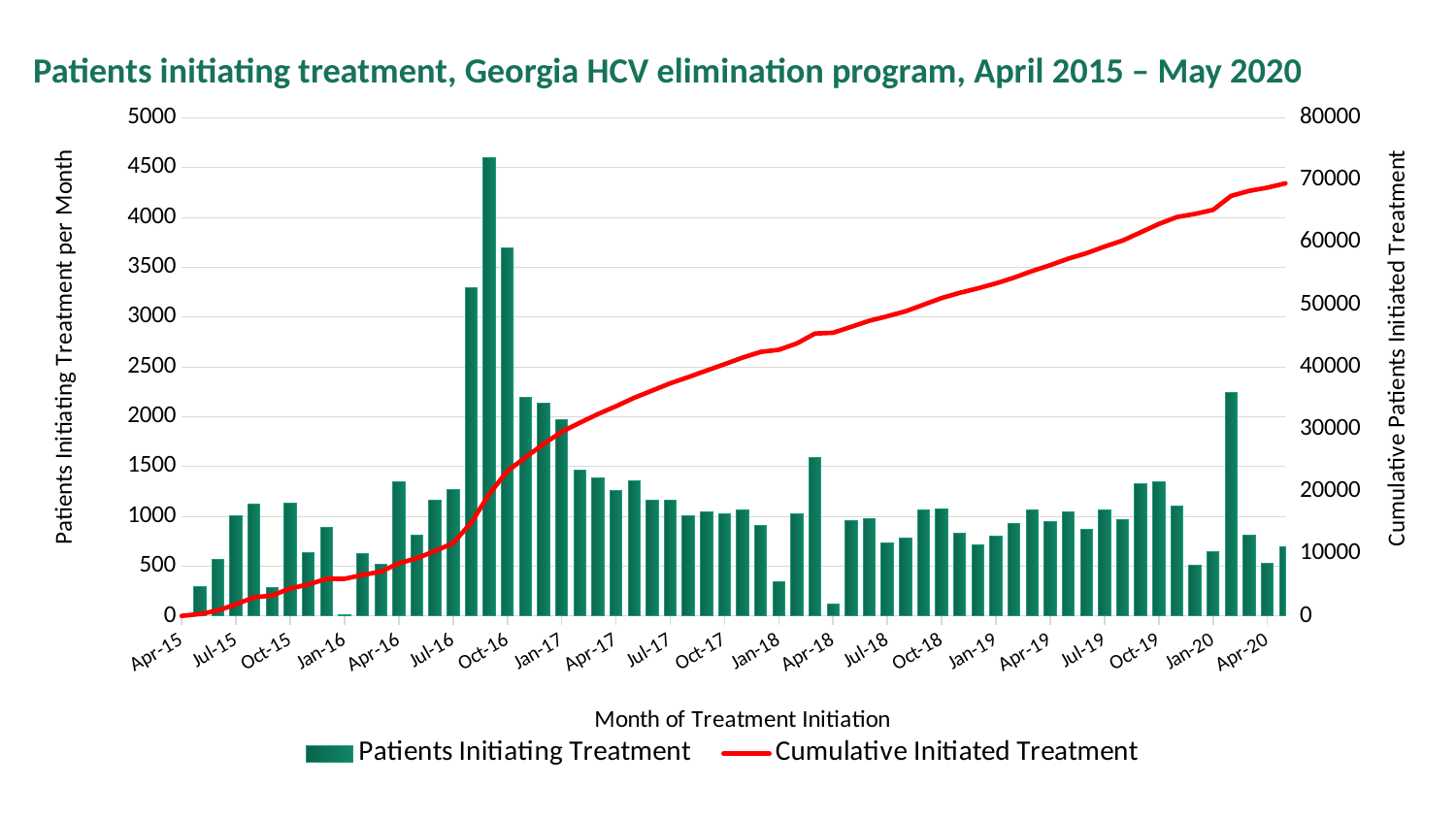
Which is larger: the Cumulative Initiated Treatment value at Jan-17 or at Jan-19? Jan-19 Is the value of the Cumulative Initiated Treatment line at Apr-16 greater or less than 10000? less What is the highest tick value shown on the right-hand axis? 80000 Does the Cumulative Initiated Treatment line rise or fall from Apr-15 to Apr-20? Rises What is the title of the chart? Patients initiating treatment, Georgia HCV elimination program, April 2015 – May 2020 What kind of chart is shown on the slide? A combined bar and line chart Is the value of the Cumulative Initiated Treatment line at Jan-18 greater or less than 40000? greater Is the value of the Cumulative Initiated Treatment line at Apr-20 greater or less than 60000? greater How many series does the legend list? 2 Which series is drawn as a red line? Cumulative Initiated Treatment